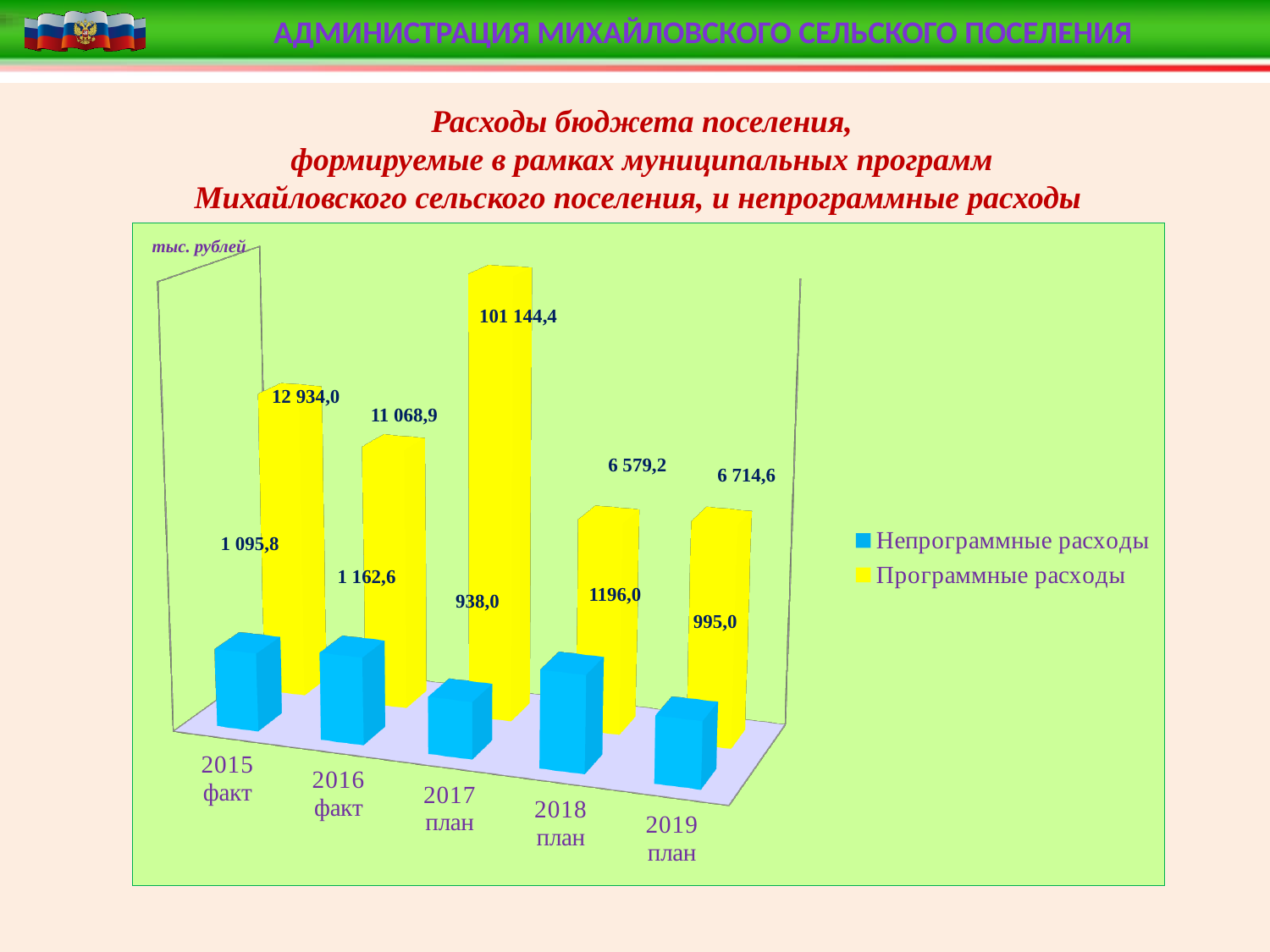
What is the difference between Программные расходы for 2019 план and 2018 план? 135,4 What is the total of Непрограммные расходы and Программные расходы for 2019 план? 7 709,6 Which category has the lowest value for Программные расходы? 2018 план What is the value of Непрограммные расходы for 2015 факт? 1 095,8 Which category has the lowest value for Непрограммные расходы? 2017 план How many series does the legend list? 2 What kind of chart is shown on the slide? Bar chart Which is larger: Программные расходы for 2015 факт or for 2016 факт? 2015 факт How many categories are shown on the x axis? 5 Which category has the highest value for Непрограммные расходы? 2018 план What is the value of Программные расходы for 2019 план? 6 714,6 What is the value of Программные расходы for 2017 план? 101 144,4